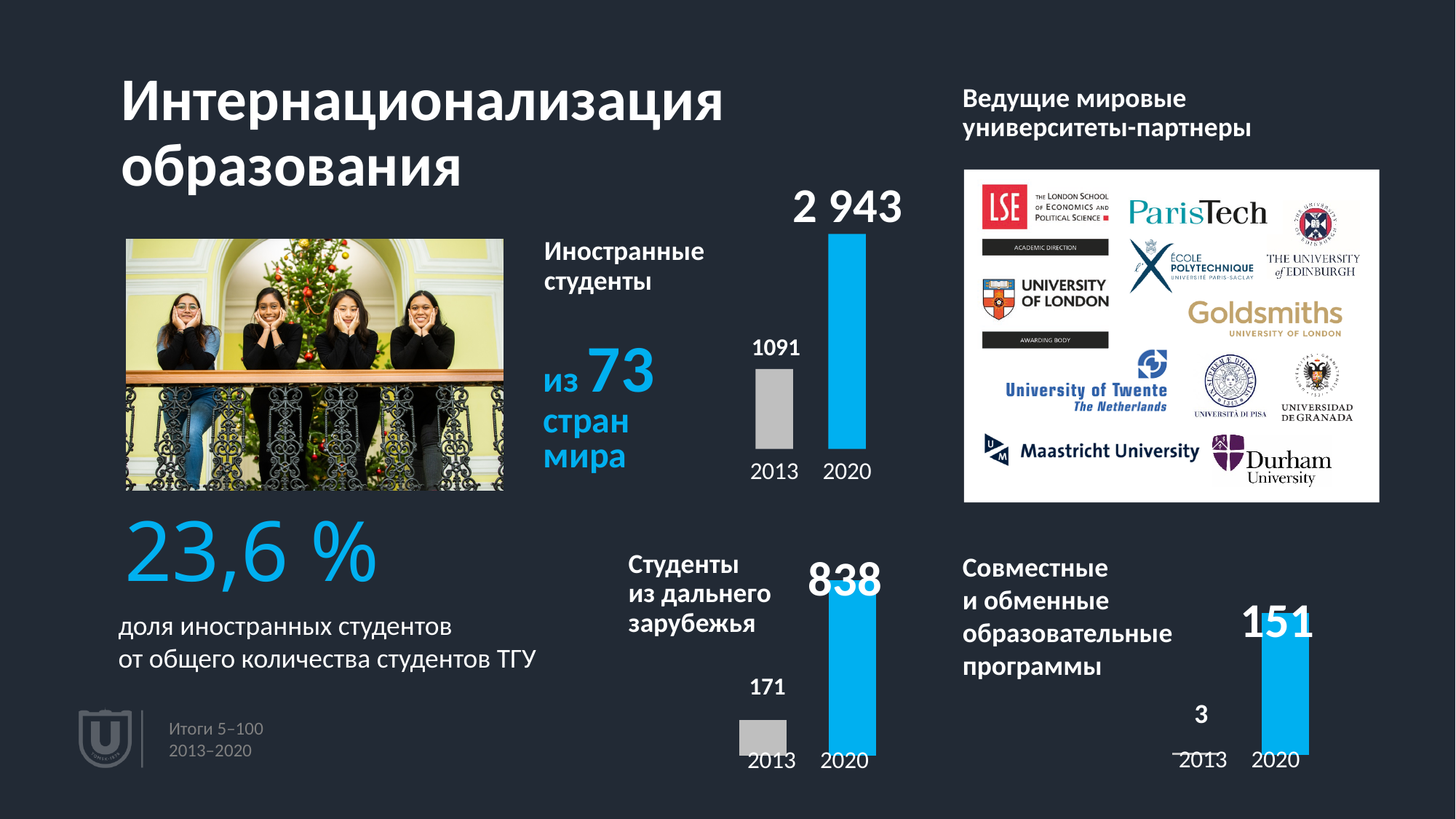
In the 'Иностранные студенты' chart, what is the value for 2013? 1091 In the 'Совместные и обменные образовательные программы' chart, what is the value for 2013? 3 In the 'Иностранные студенты' chart, what is the value for 2020? 2 943 How many bars does the 'Студенты из дальнего зарубежья' chart have? 2 In the 'Студенты из дальнего зарубежья' chart, what is the difference between the 2020 and 2013 values? 667 In the 'Студенты из дальнего зарубежья' chart, what is the value for 2020? 838 In the 'Совместные и обменные образовательные программы' chart, what is the value for 2020? 151 What kind of chart is used for 'Совместные и обменные образовательные программы'? bar chart In the 'Студенты из дальнего зарубежья' chart, what is the value for 2013? 171 In the 'Совместные и обменные образовательные программы' chart, what is the difference between the 2020 and 2013 values? 148 In the 'Иностранные студенты' chart, do the values rise or fall from 2013 to 2020? rise In the 'Иностранные студенты' chart, which year has the higher value, 2013 or 2020? 2020